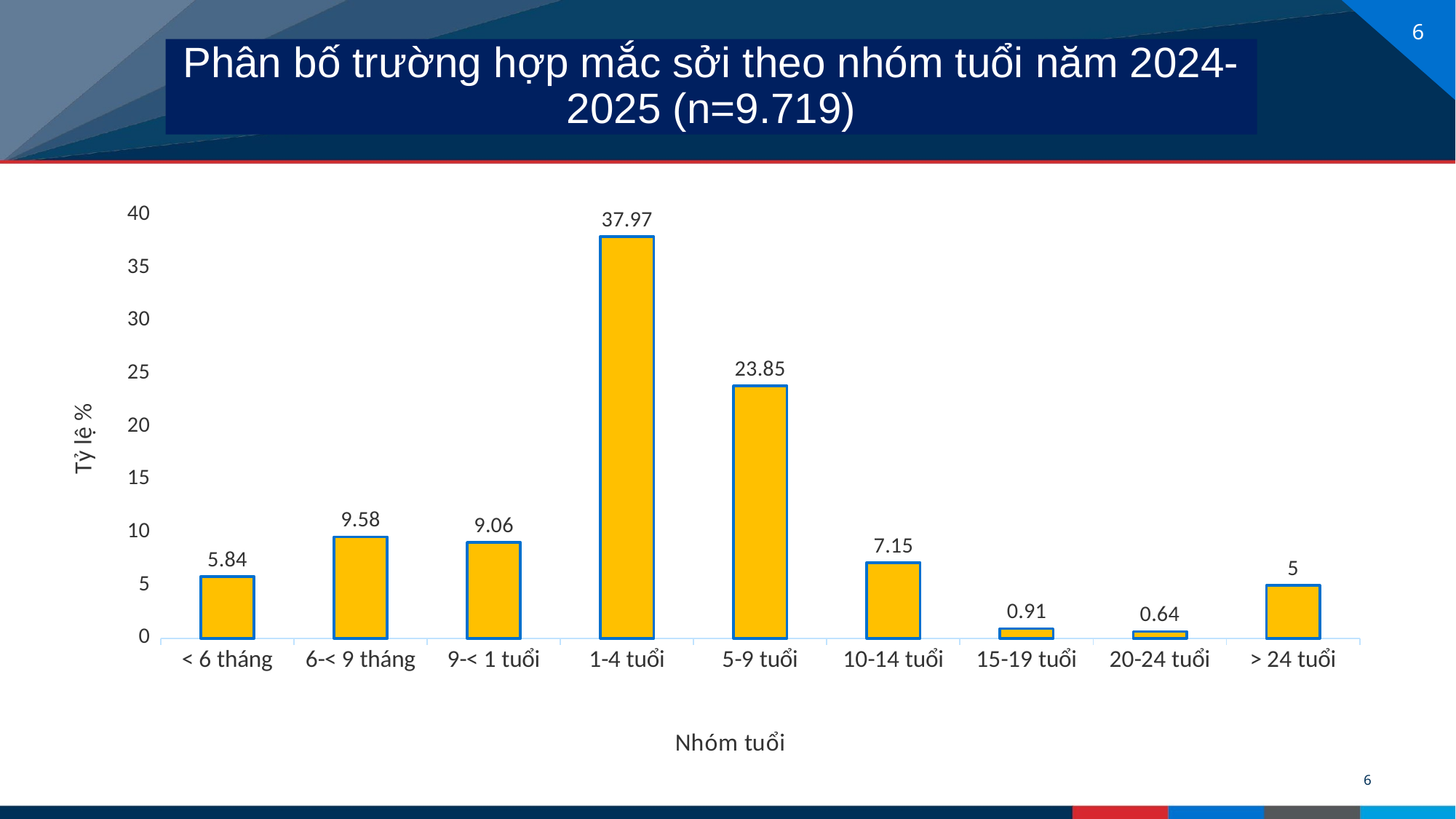
What is the value for the 20-24 tuổi age group? 0.64 Which is larger, the value for 6-< 9 tháng or the value for 9-< 1 tuổi? 6-< 9 tháng How many age groups are shown on the x axis? 9 What is the value for the 5-9 tuổi age group? 23.85 What kind of chart is shown on the slide? bar chart What is the value for the < 6 tháng age group? 5.84 What is the value for the 1-4 tuổi age group? 37.97 What is the difference between the values for 1-4 tuổi and 5-9 tuổi? 14.12 Which age group has the highest value? 1-4 tuổi Which age group has the lowest value? 20-24 tuổi Is the value for 10-14 tuổi greater or less than 10? less What is the label of the y axis? Tỷ lệ %